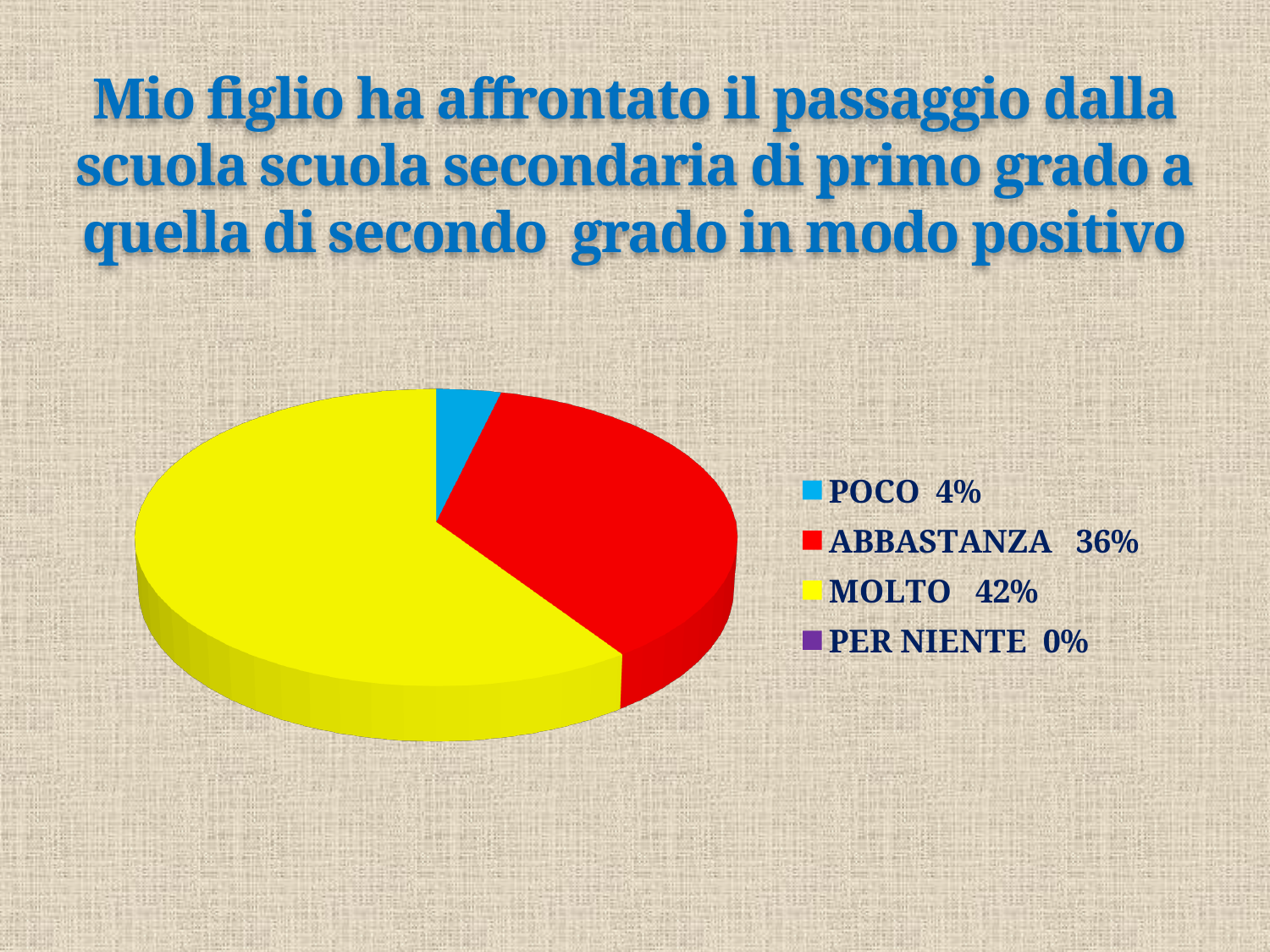
What percentage is shown for ABBASTANZA in the legend? 36% What percentage is shown for MOLTO in the legend? 42% Which category has the lowest percentage? PER NIENTE What percentage is shown for PER NIENTE in the legend? 0% What colour is the slice for MOLTO? yellow What is the difference in percentage points between MOLTO and ABBASTANZA? 6 What colour is the slice for ABBASTANZA? red Which category has the highest percentage? MOLTO What kind of chart is shown on the slide? pie chart Which is larger, the percentage for ABBASTANZA or the percentage for POCO? ABBASTANZA How many categories does the legend list? 4 What percentage is shown for POCO in the legend? 4%